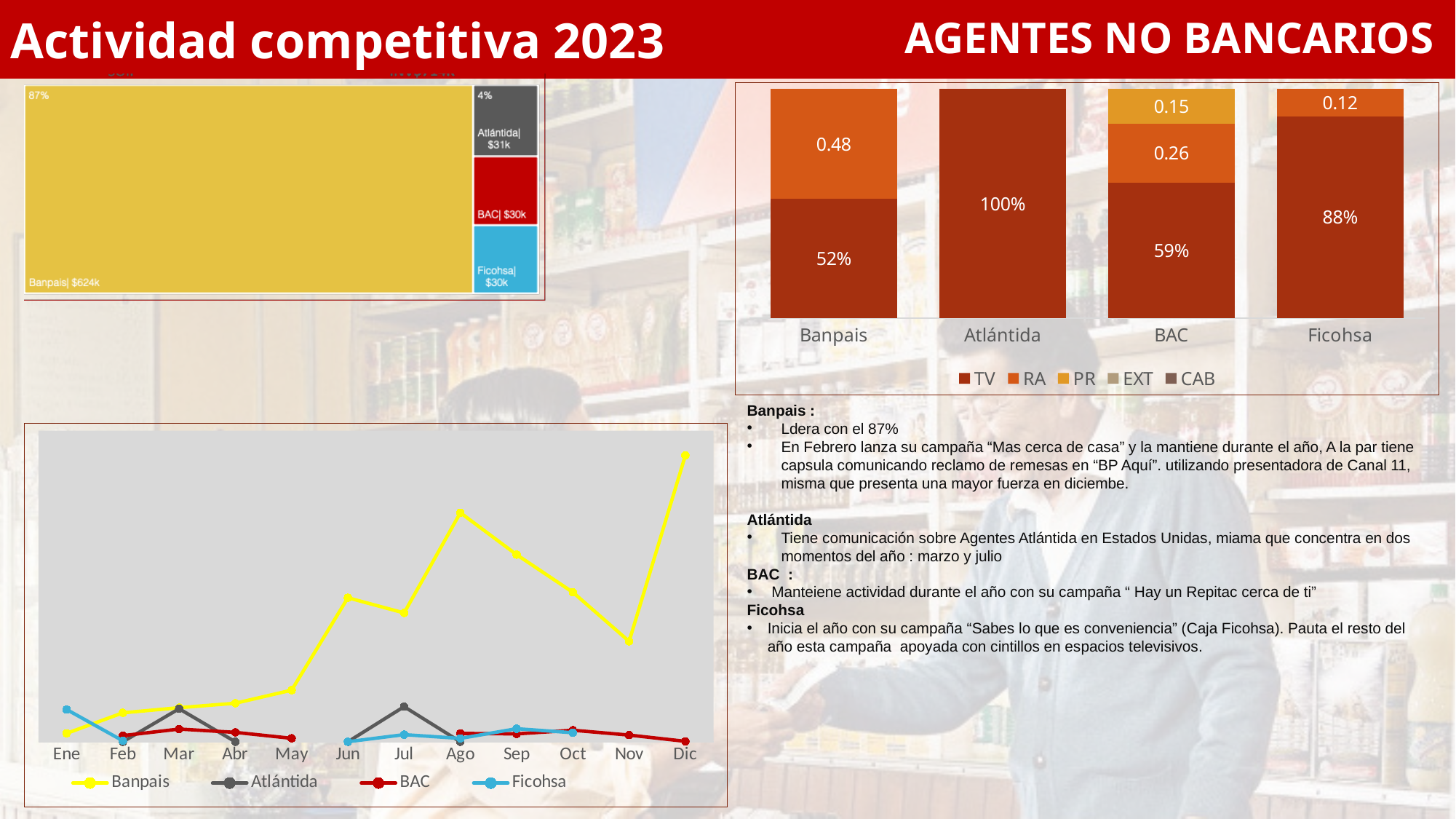
In the stacked bar chart at the top right, what is the TV value for Banpais? 52% In the line chart at the bottom left, in which month does Banpais reach its highest point? Dic In the stacked bar chart at the top right, how many series does the legend list? 5 In the treemap at the top left, what value is shown for Banpais? $624k In the stacked bar chart at the top right, what is the RA value for Ficohsa? 0.12 In the stacked bar chart at the top right, what is the TV value for Atlántida? 100% In the stacked bar chart at the top right, how many banks are shown on the x axis? 4 In the stacked bar chart at the top right, which bank has the lowest TV share? Banpais In the stacked bar chart at the top right, which bank has the highest TV share? Atlántida In the stacked bar chart at the top right, what is the PR value for BAC? 0.15 In the treemap at the top left, what percentage is shown for Atlántida? 4% In the line chart at the bottom left, how many months are shown on the x axis? 12